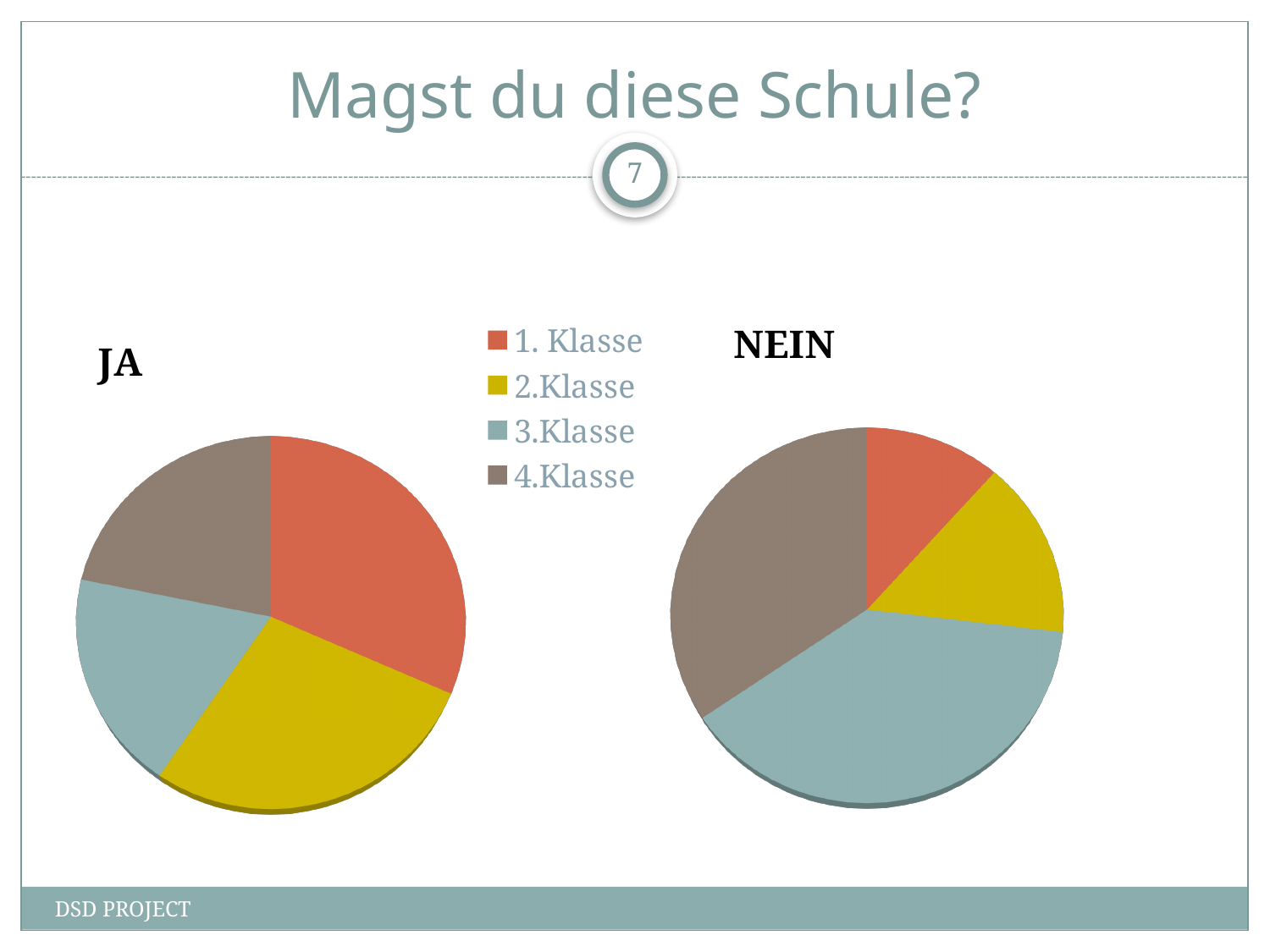
In the NEIN pie chart, which slice is larger, 3.Klasse or 1. Klasse? 3.Klasse How many slices does the JA pie chart have? 4 In the NEIN pie chart, which class has the largest slice? 3.Klasse In the JA pie chart, which slice is larger, 1. Klasse or 4.Klasse? 1. Klasse How many slices does the NEIN pie chart have? 4 What kind of chart is the JA chart? pie chart What is the title of the slide containing the two pie charts? Magst du diese Schule? Which colour represents 2.Klasse in the legend? yellow How many entries does the legend list? 4 In the JA pie chart, which slice is larger, 2.Klasse or 3.Klasse? 2.Klasse What kind of chart is the NEIN chart? pie chart